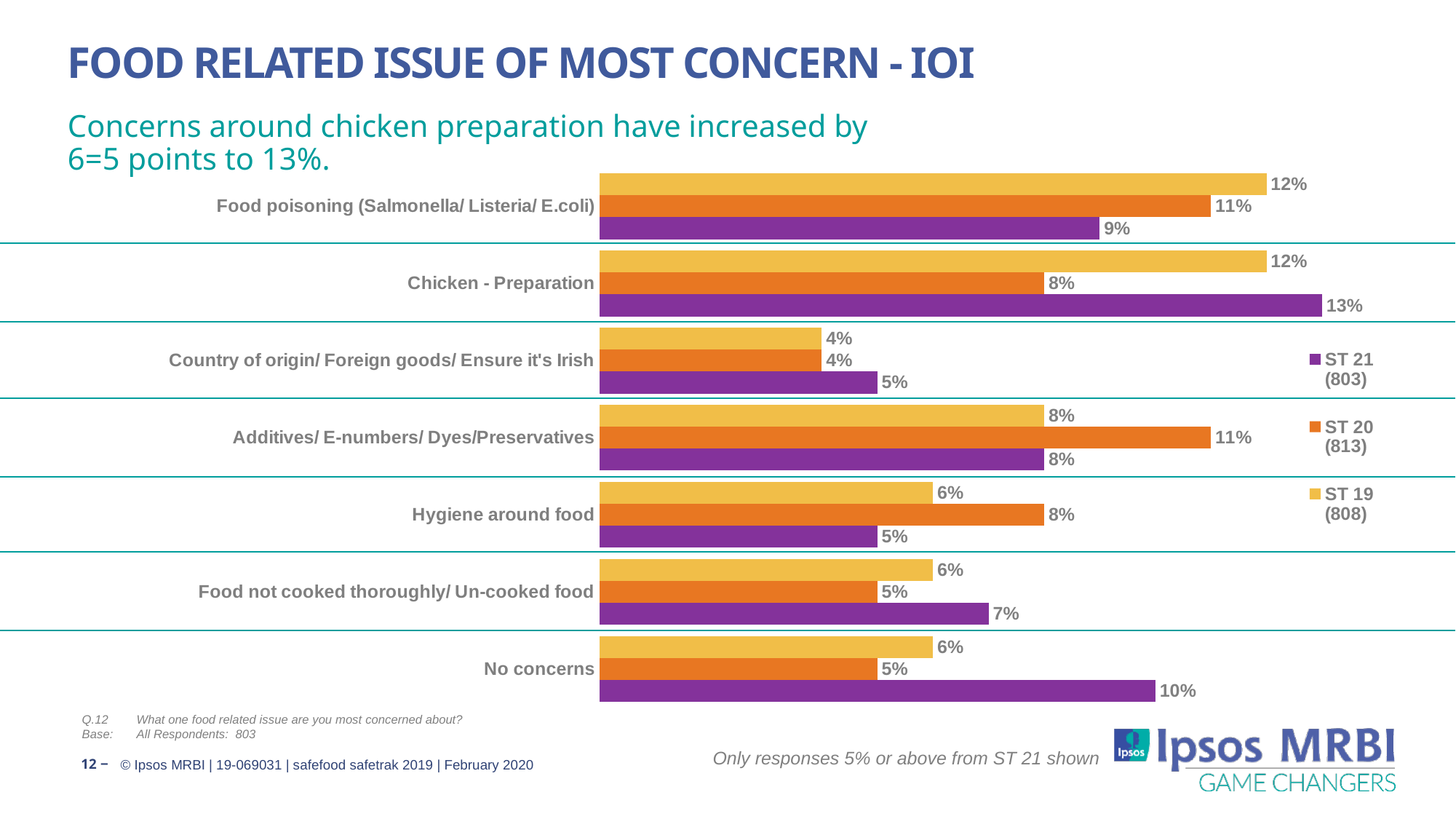
How many categories are shown in the chart? 7 What is the ST 20 value for Additives/ E-numbers/ Dyes/Preservatives? 11% For Hygiene around food, which series has the larger value, ST 20 or ST 21? ST 20 Which colour represents the ST 19 series in the chart? Yellow What is the difference between the ST 21 and ST 20 values for Chicken - Preparation? 5 percentage points What is the ST 21 value for No concerns? 10% What is the ST 21 value for Chicken - Preparation? 13% What is the ST 19 value for Food poisoning (Salmonella/ Listeria/ E.coli)? 12% How many series does the legend list? 3 Which category has the highest ST 21 value? Chicken - Preparation Which category has the lowest ST 20 value? Country of origin/ Foreign goods/ Ensure it's Irish What type of chart is shown on the slide? Bar chart